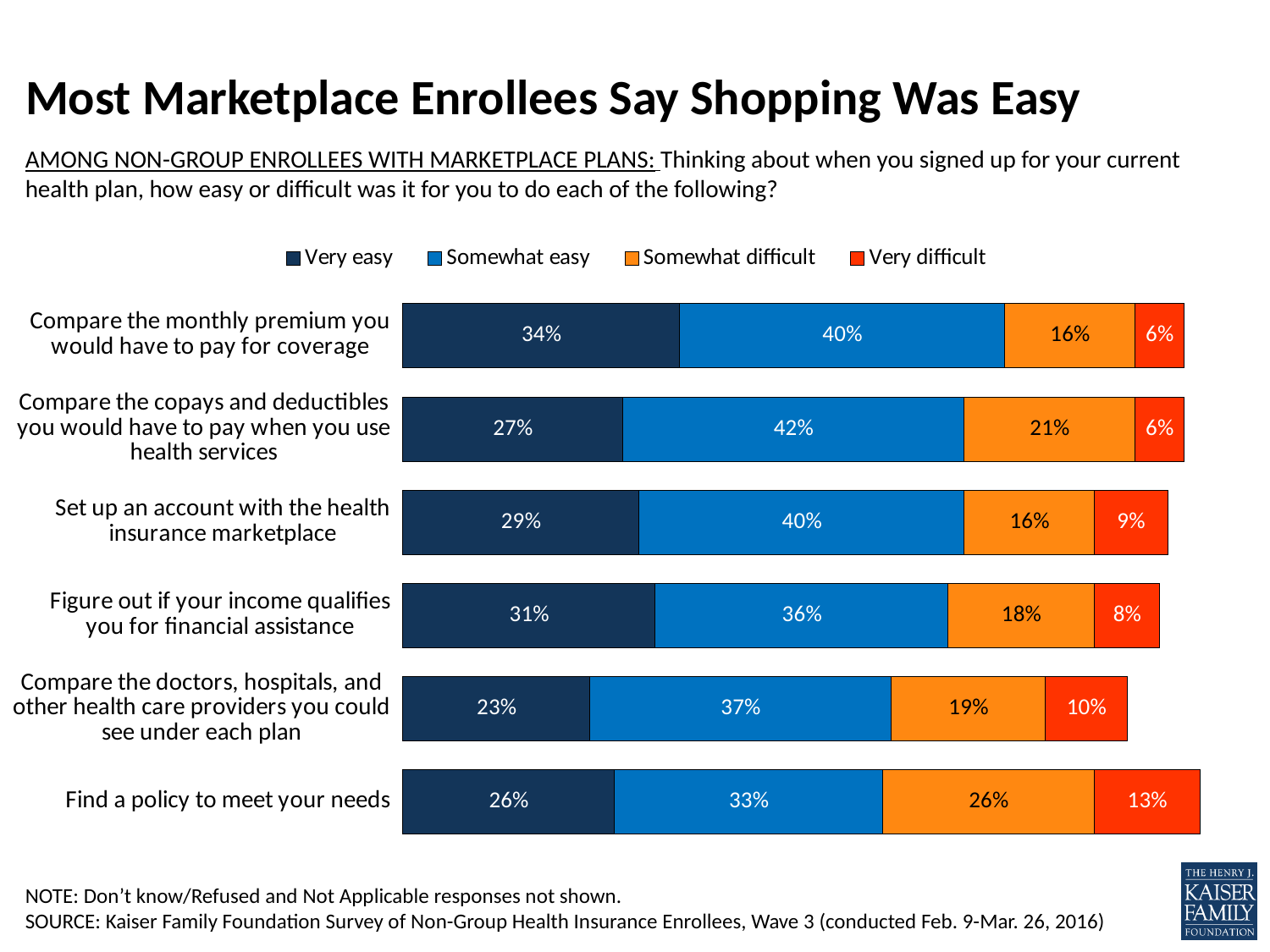
Which legend entry is shown in dark blue? Very easy Which item has the lowest "Very easy" percentage? Compare the doctors, hospitals, and other health care providers you could see under each plan What kind of chart is shown on the slide? Stacked bar chart How many items (categories) are shown in the chart? 6 What percentage said it was "Somewhat easy" to compare the copays and deductibles they would have to pay when they use health services? 42% What percentage of enrollees said it was "Very easy" to compare the monthly premium they would have to pay for coverage? 34% What is the difference between the "Somewhat difficult" percentages for "Find a policy to meet your needs" and "Compare the monthly premium you would have to pay for coverage"? 10 percentage points How many series does the legend list? 4 What percentage said it was "Very difficult" to find a policy to meet their needs? 13% What is the total of the four segments in the bar for "Find a policy to meet your needs"? 98% Which is larger: the "Very difficult" share for "Set up an account with the health insurance marketplace" or for "Figure out if your income qualifies you for financial assistance"? Set up an account with the health insurance marketplace Which item has the highest "Very easy" percentage? Compare the monthly premium you would have to pay for coverage